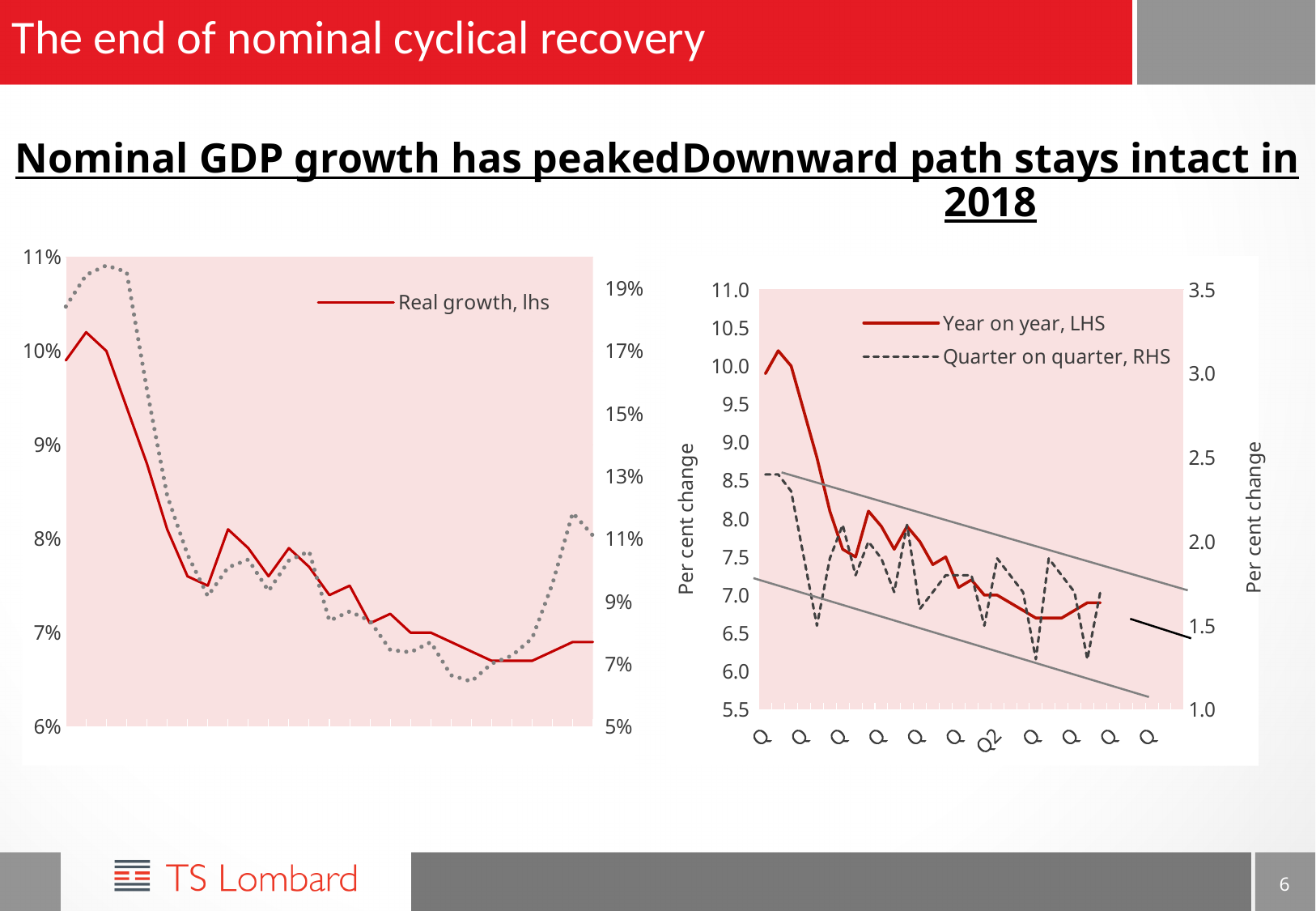
What type of chart is the right chart titled "Downward path stays intact in 2018"? Line chart How many series does the legend of the left chart "Nominal GDP growth has peaked" list? 1 In the left chart "Nominal GDP growth has peaked", does the "Real growth, lhs" line overall rise or fall from left to right? Fall In the left chart "Nominal GDP growth has peaked", is the final value of the "Real growth, lhs" line greater or less than 8%? less In the right chart "Downward path stays intact in 2018", is the final value of the "Year on year, LHS" line greater or less than 8.0? less What are the two legend entries in the right chart "Downward path stays intact in 2018"? Year on year, LHS; Quarter on quarter, RHS In the right chart "Downward path stays intact in 2018", is the peak value of the "Year on year, LHS" line greater or less than 9.5? greater What is the title of the vertical axes in the right chart "Downward path stays intact in 2018"? Per cent change How many series does the legend of the right chart "Downward path stays intact in 2018" list? 2 In the right chart "Downward path stays intact in 2018", does the "Year on year, LHS" line overall rise or fall from left to right? Fall What type of chart is the left chart titled "Nominal GDP growth has peaked"? Line chart